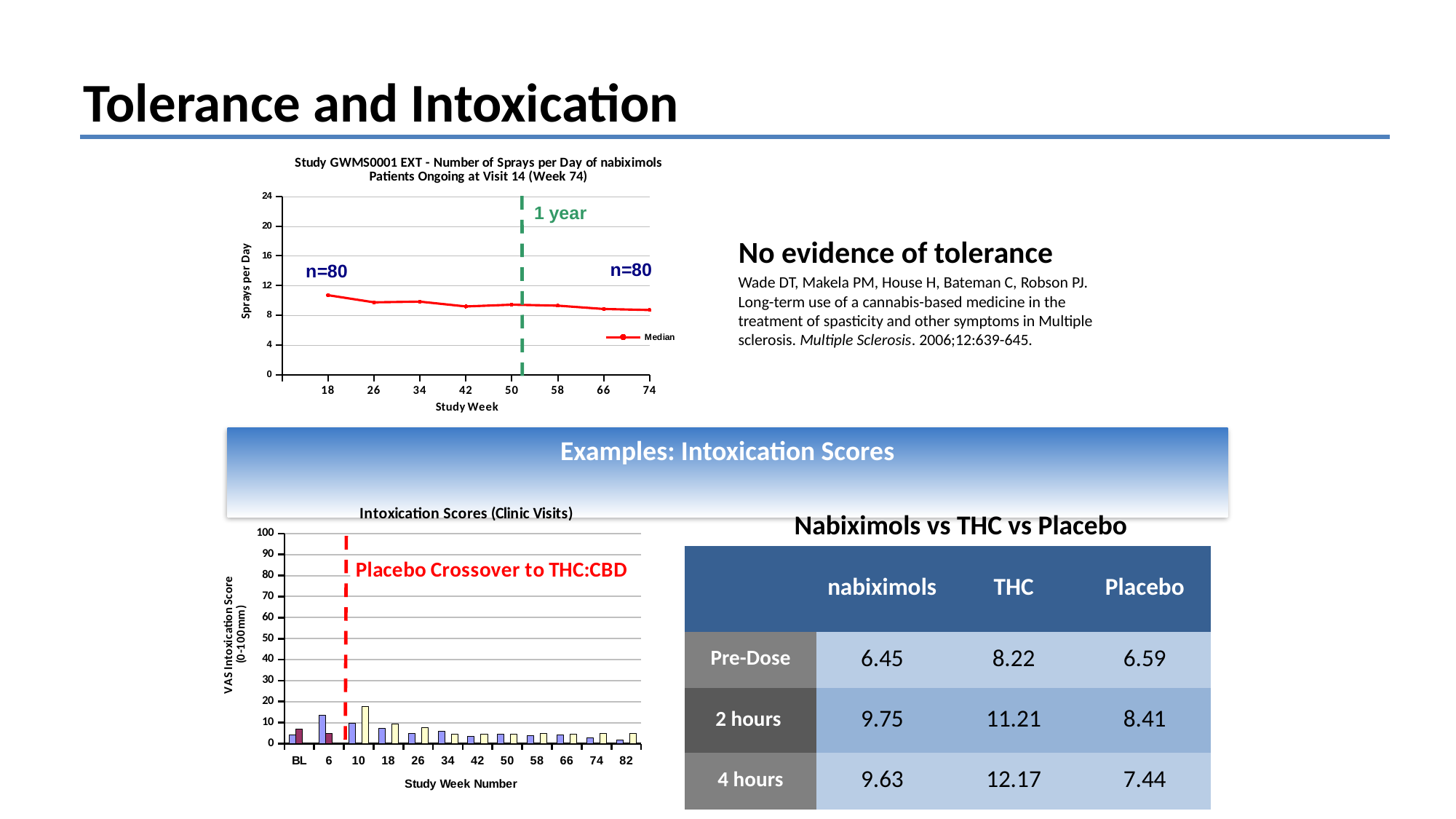
In the bottom chart (Intoxication Scores), is the tallest bar greater or less than 30? less In the top chart (Number of Sprays per Day), do the median sprays per day rise or fall from week 18 to week 74? fall What kind of chart is the top chart titled 'Study GWMS0001 EXT - Number of Sprays per Day of nabiximols'? line chart What kind of chart is the bottom chart titled 'Intoxication Scores (Clinic Visits)'? bar chart In the top chart (Number of Sprays per Day), how many series does the legend list? 1 In the bottom chart (Intoxication Scores), what is the label of the y axis? VAS Intoxication Score (0-100mm) In the top chart (Number of Sprays per Day), how many study weeks are labelled on the x axis? 8 In the top chart (Number of Sprays per Day), is the median value at study week 18 greater or less than 8? greater In the top chart (Number of Sprays per Day), what is the name of the series shown in the legend? Median In the top chart (Number of Sprays per Day), at which study week is the median sprays per day highest? 18 In the top chart (Number of Sprays per Day), is the median value at study week 74 greater or less than 12? less In the bottom chart (Intoxication Scores), how many study week labels are shown on the x axis? 12